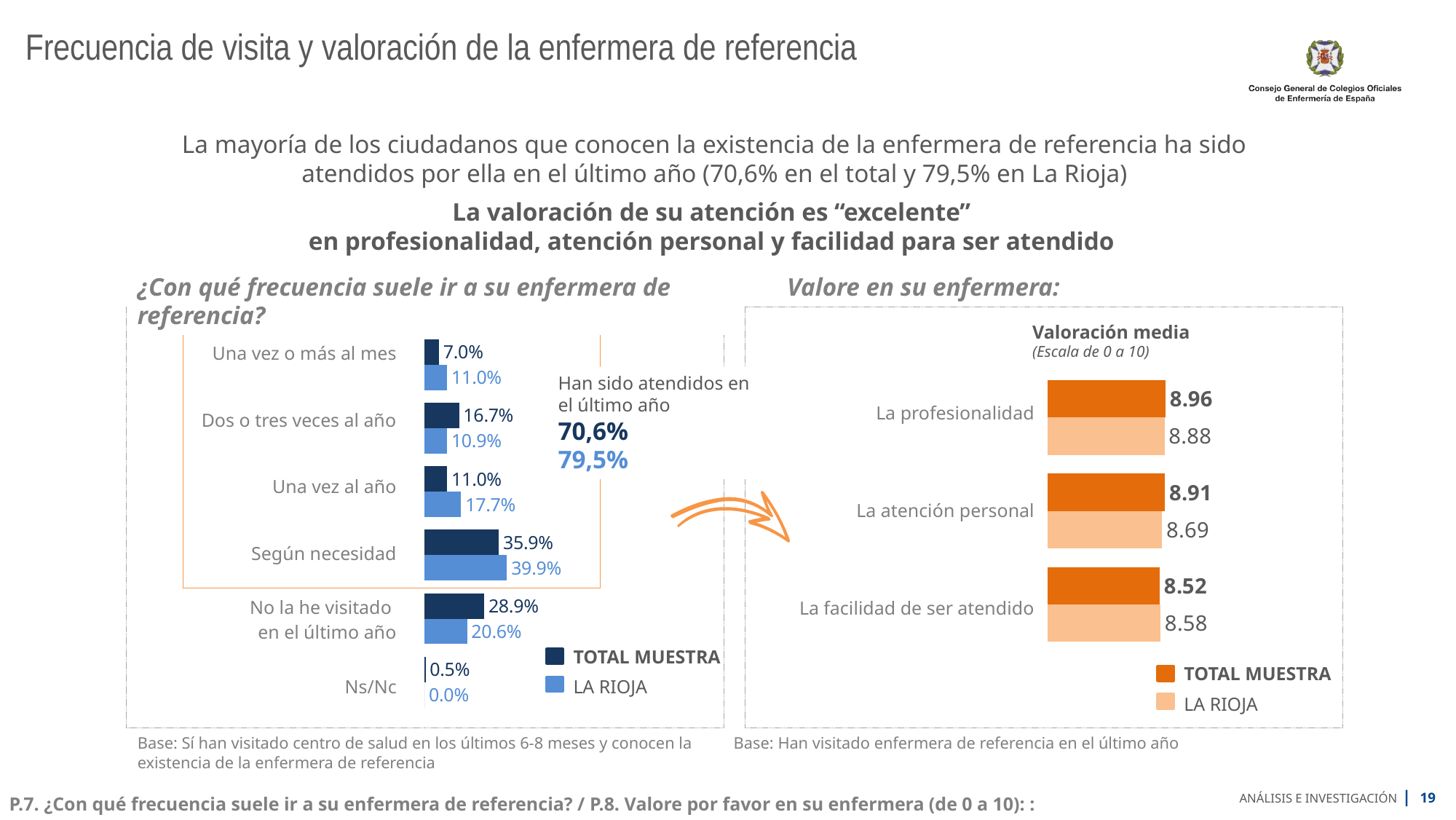
In the left chart on visit frequency, which is larger for 'Dos o tres veces al año': TOTAL MUESTRA or LA RIOJA? TOTAL MUESTRA What type of chart is the right chart 'Valore en su enfermera'? Bar chart In the right chart 'Valore en su enfermera', which is larger for 'La facilidad de ser atendido': TOTAL MUESTRA or LA RIOJA? LA RIOJA In the left chart on visit frequency, what is the difference between the TOTAL MUESTRA and LA RIOJA values for 'No la he visitado en el último año'? 8.3% In the left chart on visit frequency, what is the LA RIOJA value for 'Una vez al año'? 17.7% In the left chart on visit frequency, what is the TOTAL MUESTRA value for 'Según necesidad'? 35.9% In the right chart 'Valore en su enfermera', what is the LA RIOJA rating for 'La atención personal'? 8.69 How many series does the legend of the right chart 'Valore en su enfermera' list? 2 In the left chart on visit frequency, which category has the highest LA RIOJA value? Según necesidad In the left chart on visit frequency, which category has the lowest TOTAL MUESTRA value? Ns/Nc How many categories are shown in the left chart on visit frequency? 6 In the right chart 'Valore en su enfermera', what is the TOTAL MUESTRA rating for 'La profesionalidad'? 8.96